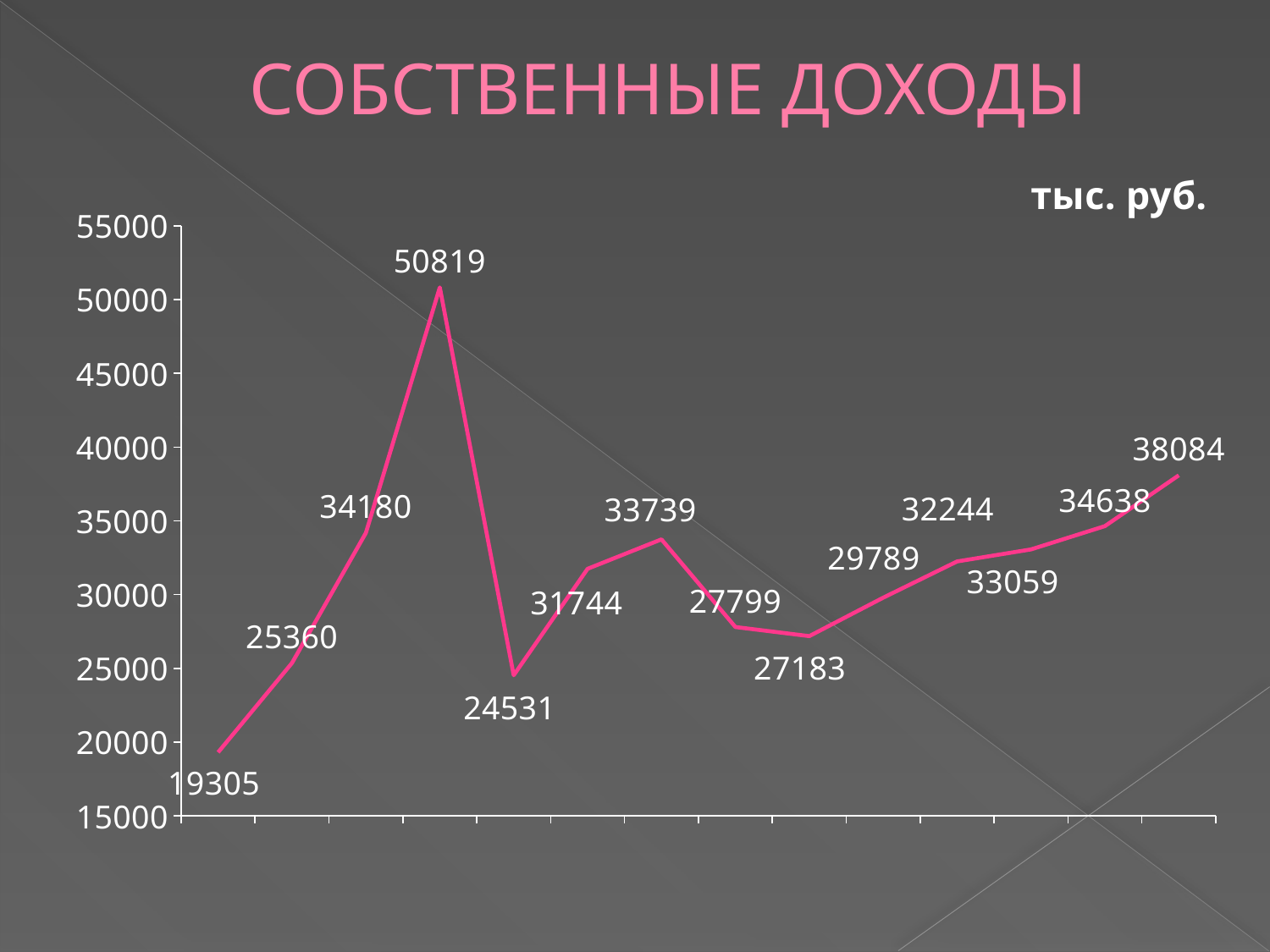
Is the value of the fourth point on the line greater or less than 50000? greater What unit is indicated for the values in the chart? тыс. руб. How many data points are plotted on the line? 14 Do the values rise or fall from the first point to the fourth point on the line? rise What is the value of the last point on the line? 38084 What is the lowest value plotted on the line? 19305 What is the value of the first point on the line? 19305 What is the difference between the highest value (50819) and the lowest value (19305)? 31514 What is the highest value plotted on the line? 50819 What kind of chart is shown on the slide? line chart What is the difference between the last point (38084) and the first point (19305)? 18779 What is the title of the chart? СОБСТВЕННЫЕ ДОХОДЫ